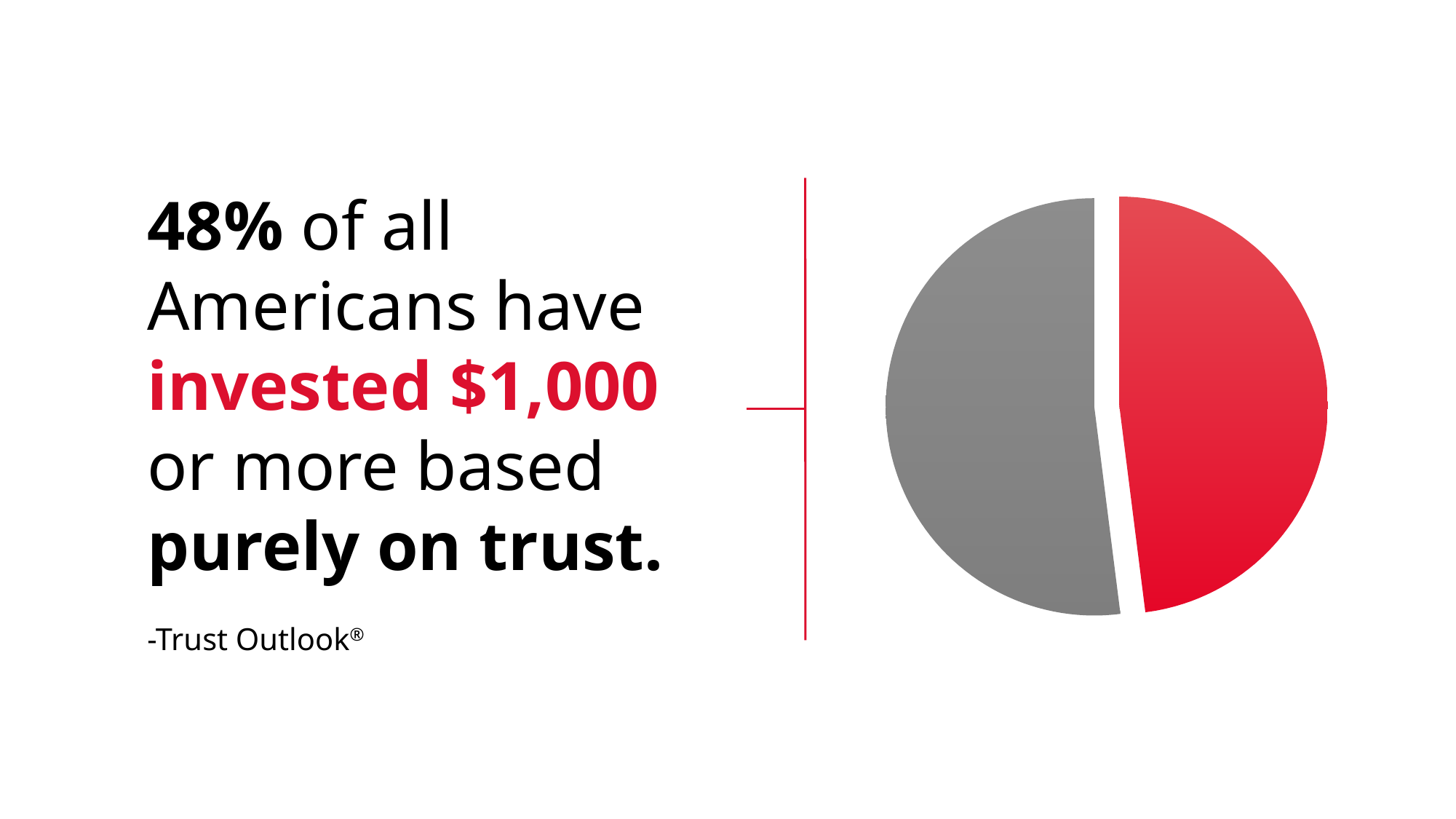
What two colours are used for the slices of the pie chart? red and gray What share of the pie does the red slice represent? 48% Is the share represented by the red slice greater or less than 50%? less Which slice of the pie is larger, the red one or the gray one? the gray one How many slices does the pie chart have? 2 What source is cited for the statistic illustrated by the pie chart? Trust Outlook What kind of chart is shown on the slide? pie chart